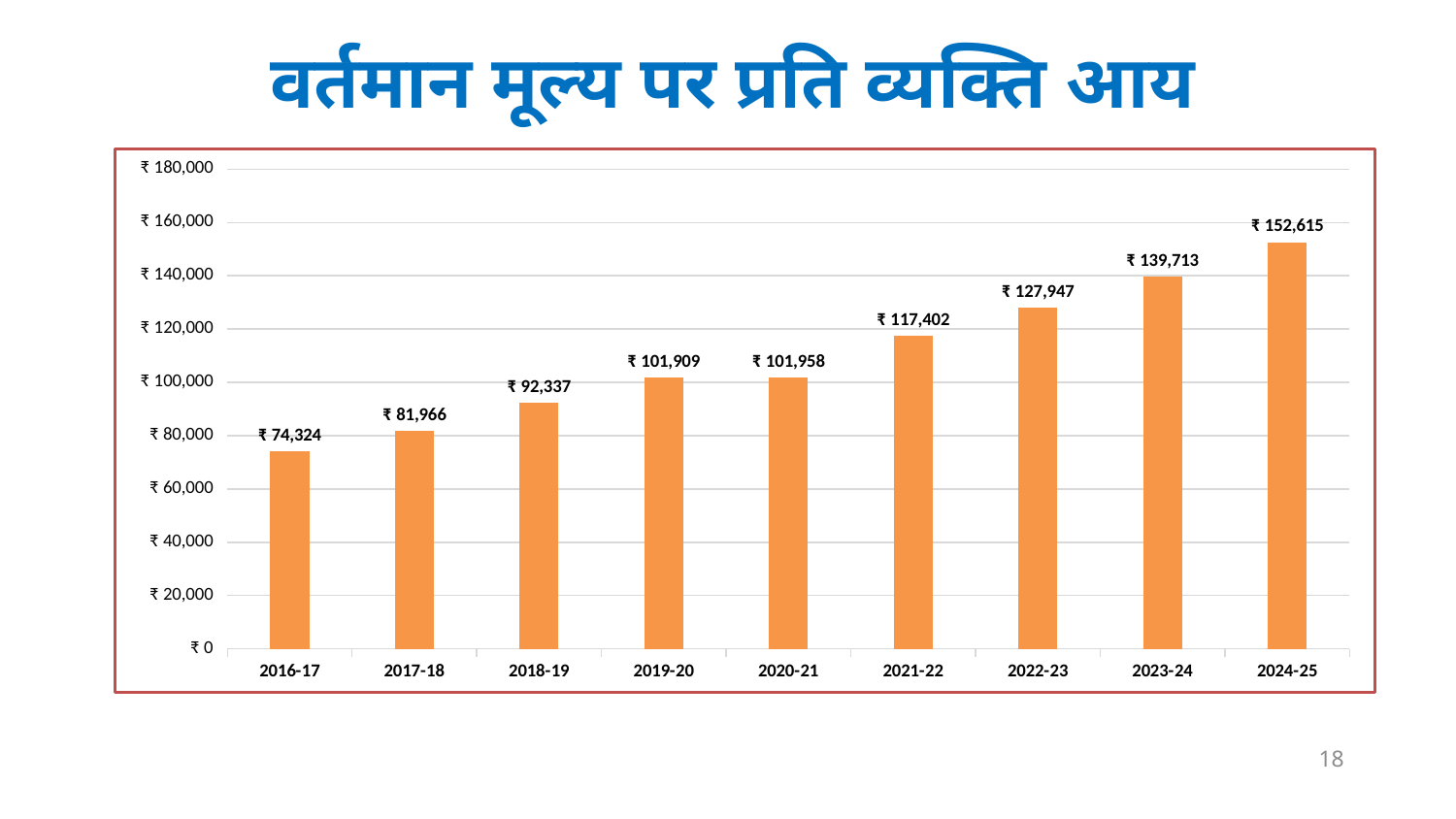
Which year has the highest value? 2024-25 Which is larger, the value for 2018-19 or the value for 2021-22? 2021-22 What is the difference between the values for 2023-24 and 2022-23? ₹ 11,766 What is the value for 2016-17? ₹ 74,324 What is the value for 2021-22? ₹ 117,402 How many years are shown on the x axis? 9 What is the difference between the values for 2024-25 and 2016-17? ₹ 78,291 What kind of chart is shown on the slide? bar chart Do the values generally rise or fall from 2016-17 to 2024-25? rise What is the value for 2023-24? ₹ 139,713 Which year has the lowest value? 2016-17 Is the value for 2022-23 greater or less than ₹ 120,000? greater